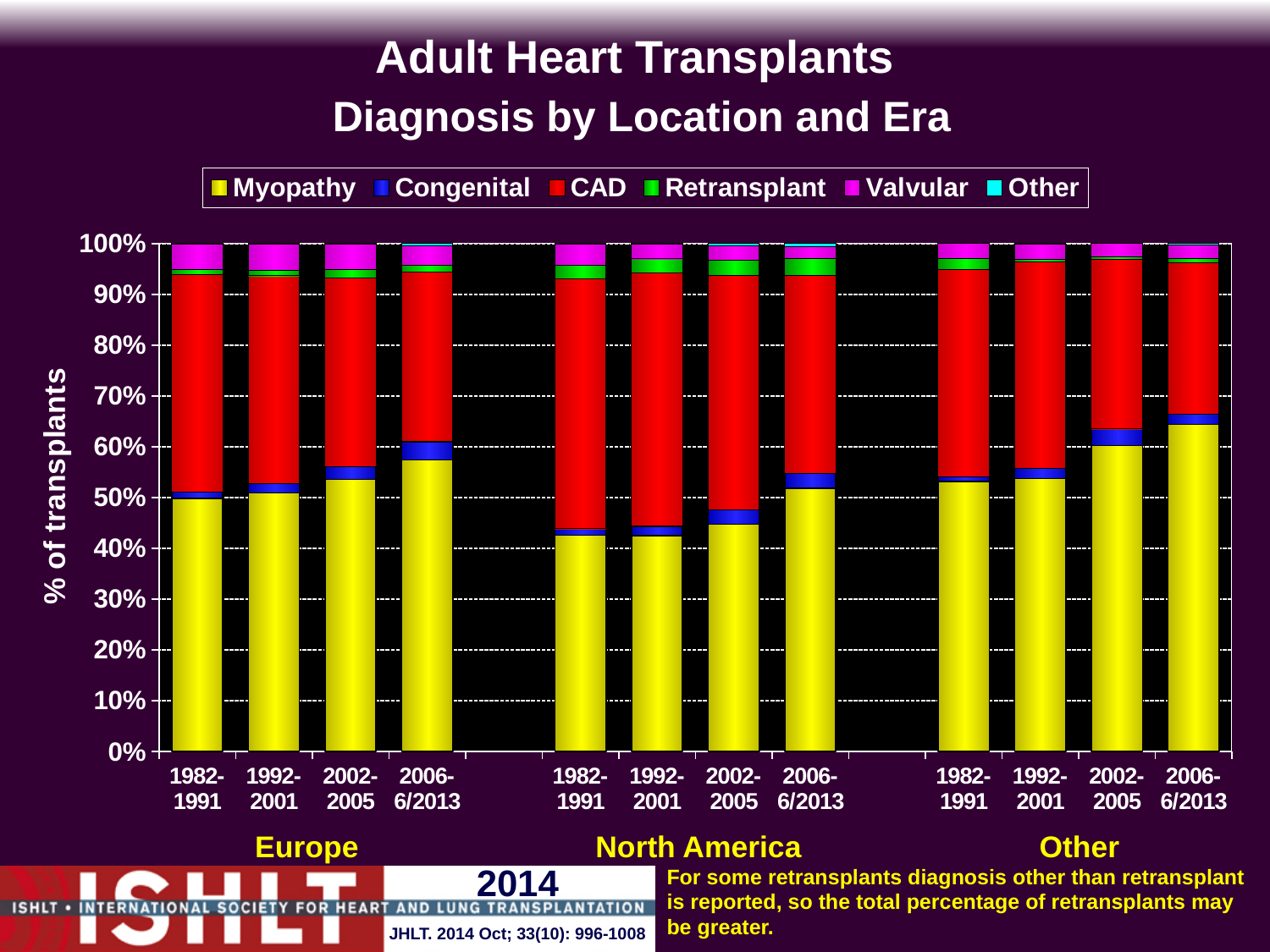
Does the Myopathy share in Europe rise or fall across the eras from 1982-1991 to 2006-6/2013? rise Is the Myopathy share for North America in 1982-1991 greater or less than 50%? less How many location groups are shown along the x axis? 3 Is the Myopathy share for Other in 2006-6/2013 greater or less than 60%? greater What is the label on the y axis? % of transplants How many series does the legend list? 6 Which colour represents CAD in the legend? Red Is the Myopathy share for Europe in 2006-6/2013 greater or less than 50%? greater Which has the larger Myopathy share in 1982-1991: Europe or North America? Europe What kind of chart is shown on the slide? Stacked bar chart How many bars are plotted in the chart in total? 12 Within the Other location group, which era has the highest Myopathy share? 2006-6/2013